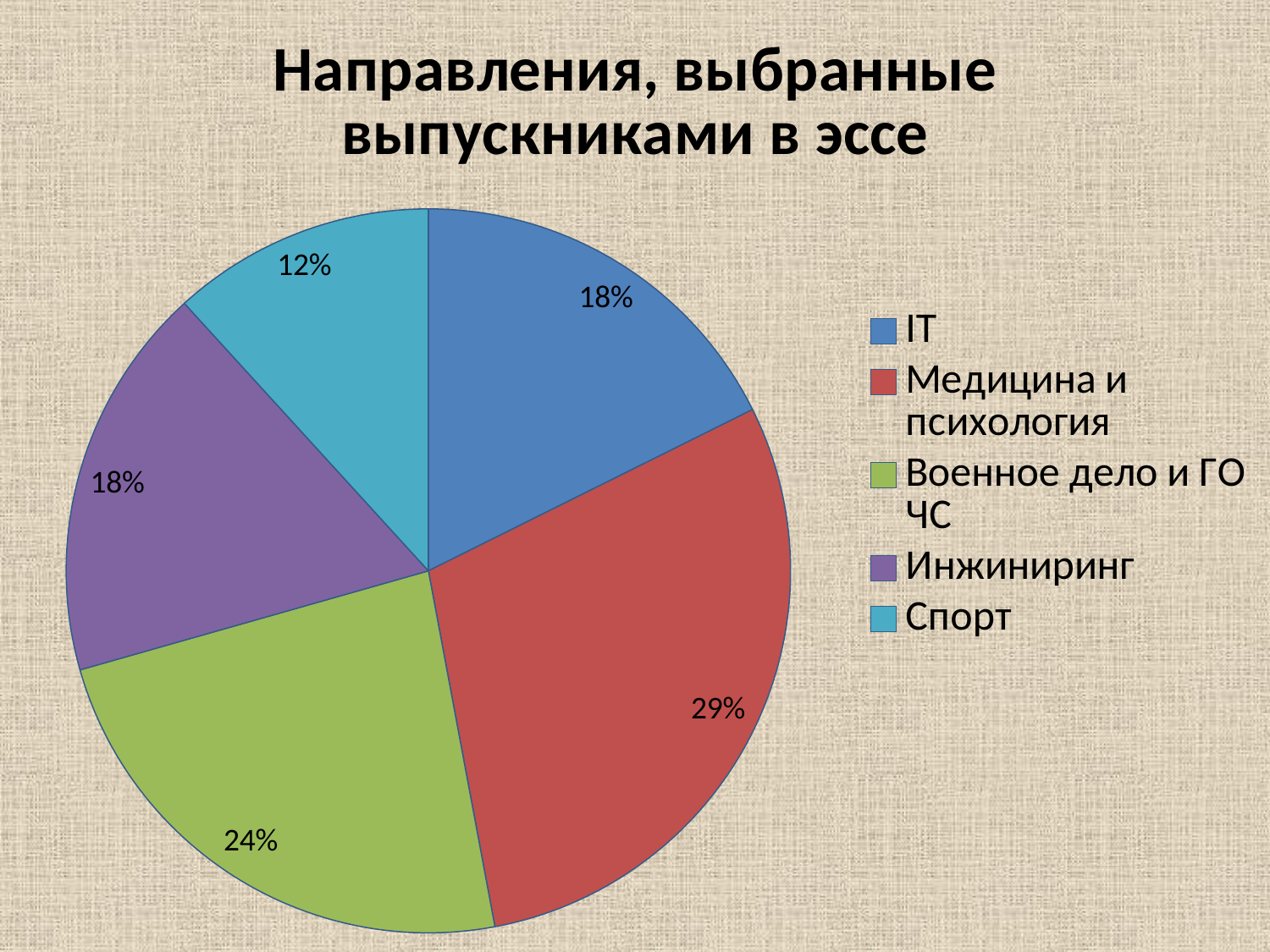
What share of the pie does Инжиниринг have? 18% Which category has the smallest slice of the pie? Спорт What share of the pie does IT have? 18% Which category has the largest slice of the pie? Медицина и психология What is the difference in percentage points between Медицина и психология and Спорт? 17 What share of the pie does Медицина и психология have? 29% What is the difference in percentage points between Военное дело и ГО ЧС and IT? 6 How many categories does the pie chart show? 5 What kind of chart is shown on the slide? Pie chart Which is larger, the share for Военное дело и ГО ЧС or the share for Спорт? Военное дело и ГО ЧС